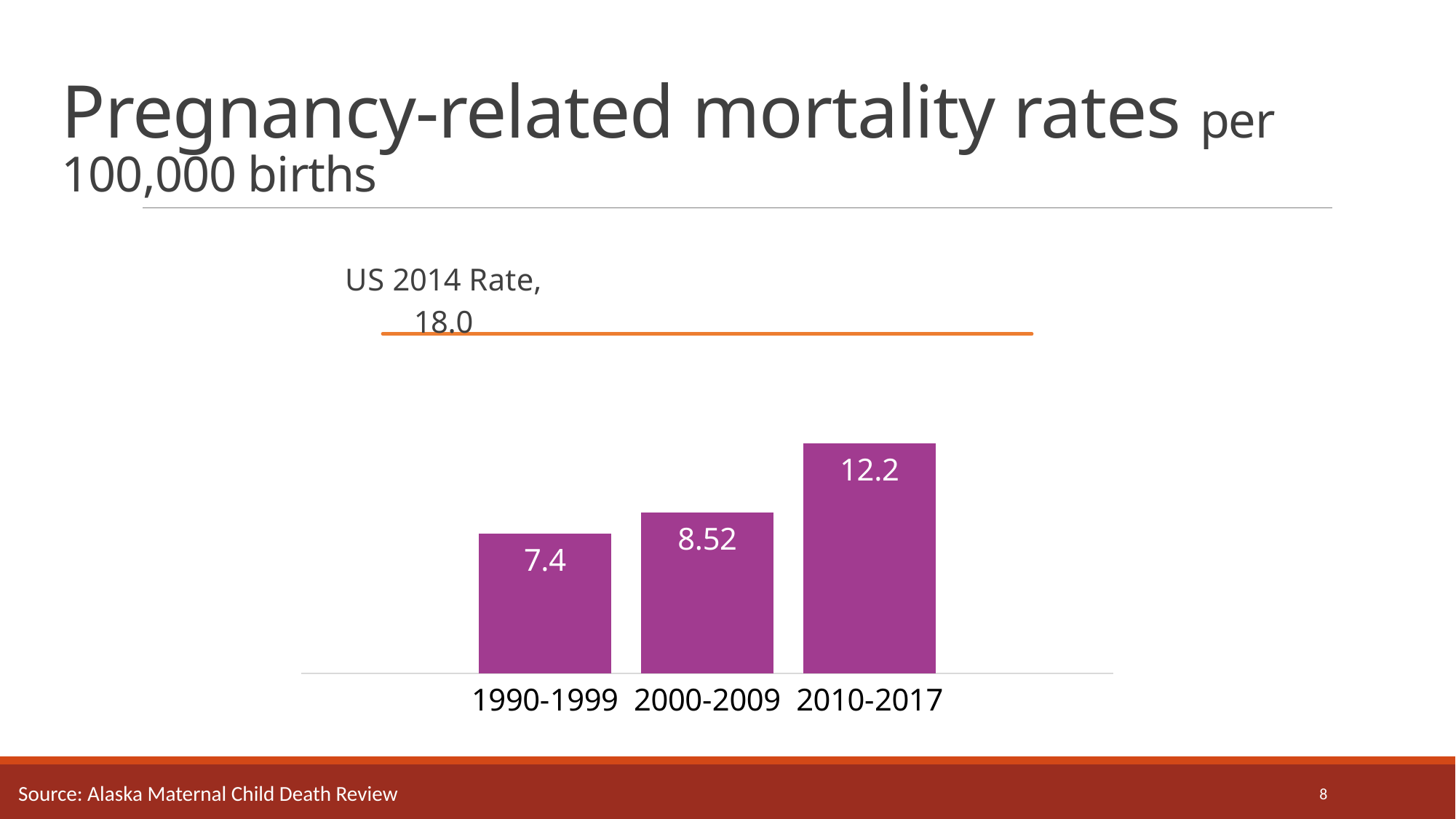
What kind of chart is shown on the slide? Bar chart What is the pregnancy-related mortality rate for 1990-1999? 7.4 Do the pregnancy-related mortality rates rise or fall from 1990-1999 to 2010-2017? Rise What is the difference between the 2010-2017 rate and the 1990-1999 rate? 4.8 How many time periods are shown as bars in the chart? 3 Which period has the lowest pregnancy-related mortality rate? 1990-1999 What is the US 2014 rate shown by the reference line? 18.0 Which is larger, the rate for 2000-2009 or the rate for 2010-2017? 2010-2017 What is the difference between the US 2014 rate and the 2010-2017 rate? 5.8 What is the pregnancy-related mortality rate for 2000-2009? 8.52 Which period has the highest pregnancy-related mortality rate? 2010-2017 What is the pregnancy-related mortality rate for 2010-2017? 12.2